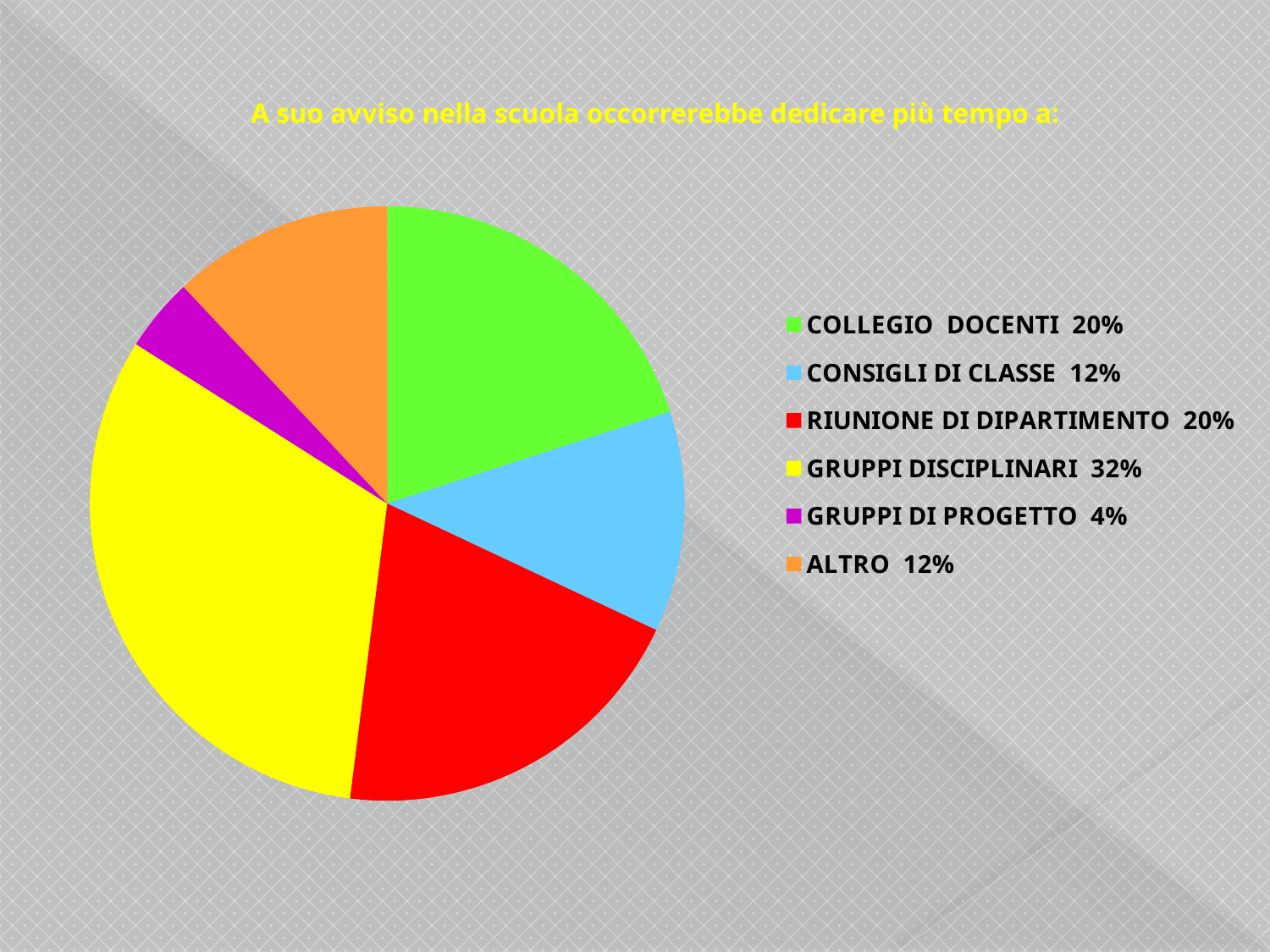
Which category has the largest share of the pie? GRUPPI DISCIPLINARI What is the difference between the shares of GRUPPI DISCIPLINARI and COLLEGIO DOCENTI? 12% What percentage is shown for GRUPPI DI PROGETTO? 4% How many categories does the pie chart have? 6 Which category has the smallest share of the pie? GRUPPI DI PROGETTO Which is larger, the share for ALTRO or the share for GRUPPI DI PROGETTO? ALTRO What colour is the slice for GRUPPI DISCIPLINARI? yellow What type of chart is shown on the slide? pie chart What percentage is shown for GRUPPI DISCIPLINARI? 32% What is the title of the chart? A suo avviso nella scuola occorrerebbe dedicare più tempo a: What percentage is shown for RIUNIONE DI DIPARTIMENTO? 20% What percentage is shown for CONSIGLI DI CLASSE? 12%